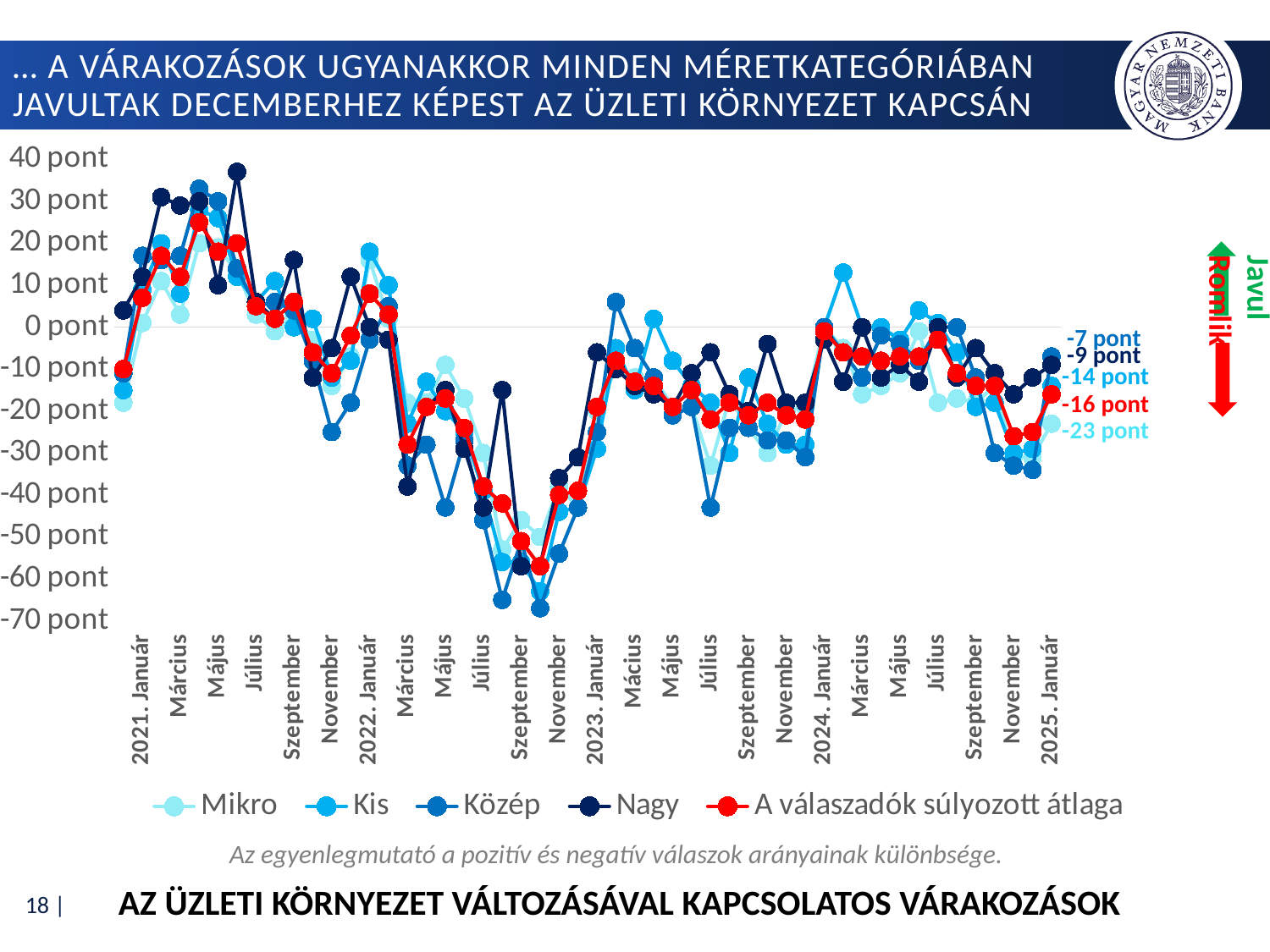
Which series has the lowest value at 2025. Január? Mikro What is the value for Mikro at 2025. Január? -23 pont At 2025. Január, which is larger: the value for Kis or the value for Közép? Közép What is the value for A válaszadók súlyozott átlaga at 2025. Január? -16 pont Which legend entry is drawn in red? A válaszadók súlyozott átlaga What kind of chart is shown on the slide? line chart What is the difference between the Nagy and Mikro values at 2025. Január? 14 pont What is the value for Nagy at 2025. Január, as labelled at the end of the line? -9 pont Is the value for A válaszadók súlyozott átlaga at 2022. Január greater or less than 0 pont? greater What is the value for Kis at 2025. Január? -14 pont Which series has the highest value at 2025. Január? Közép How many series does the legend list? 5